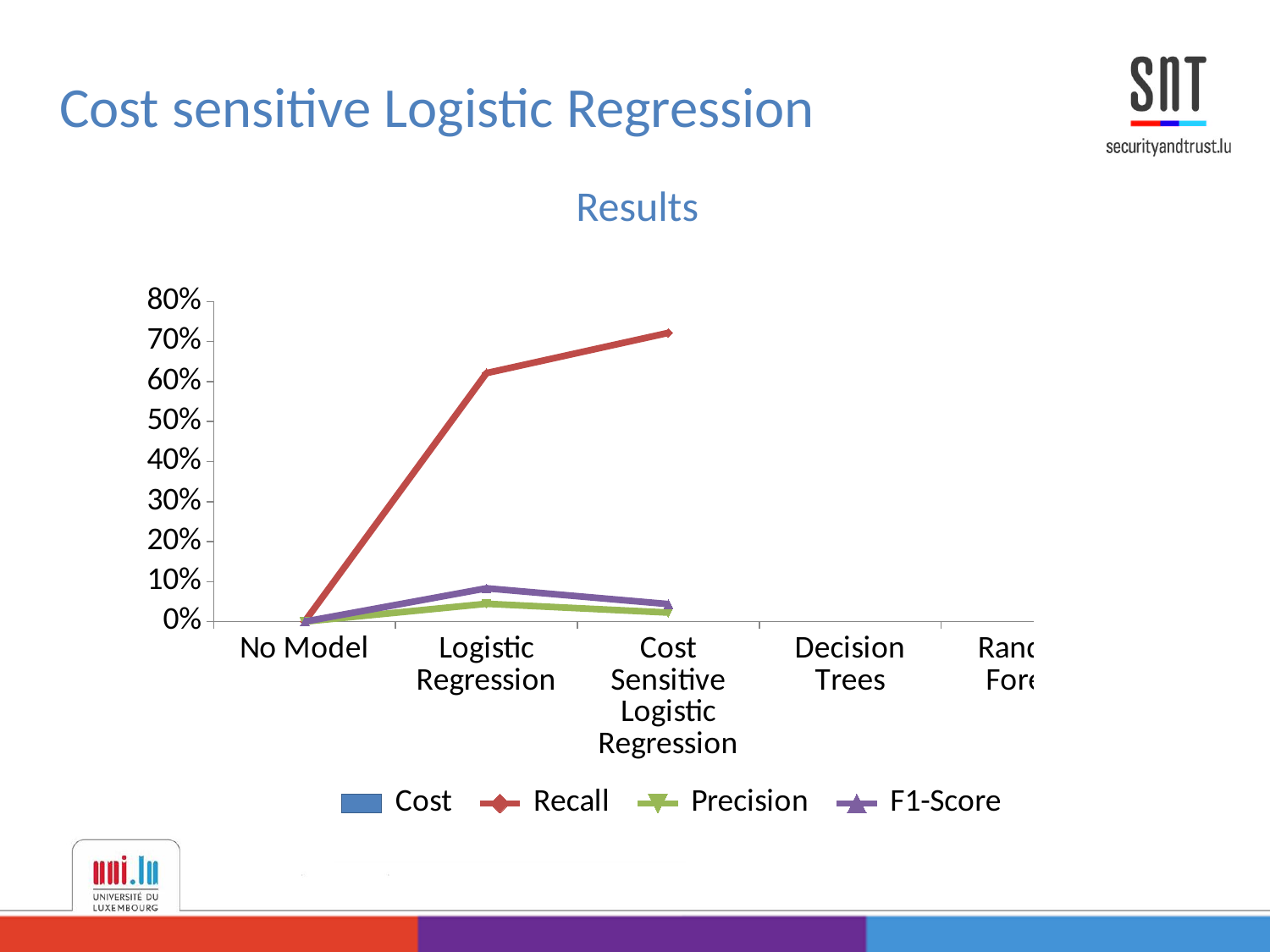
Which category has the highest Recall value? Cost Sensitive Logistic Regression Is the F1-Score value for Cost Sensitive Logistic Regression greater or less than 10%? less What is the title of the chart? Results What kind of chart is shown on the slide? line chart Is the Recall value for Cost Sensitive Logistic Regression greater or less than 60%? greater For Logistic Regression, which is larger: Recall or Precision? Recall Does the Recall series rise or fall from No Model to Cost Sensitive Logistic Regression? rise Is the Recall value for Logistic Regression greater or less than 50%? greater How many series does the legend list? 4 Which colour is used for the Recall series? red